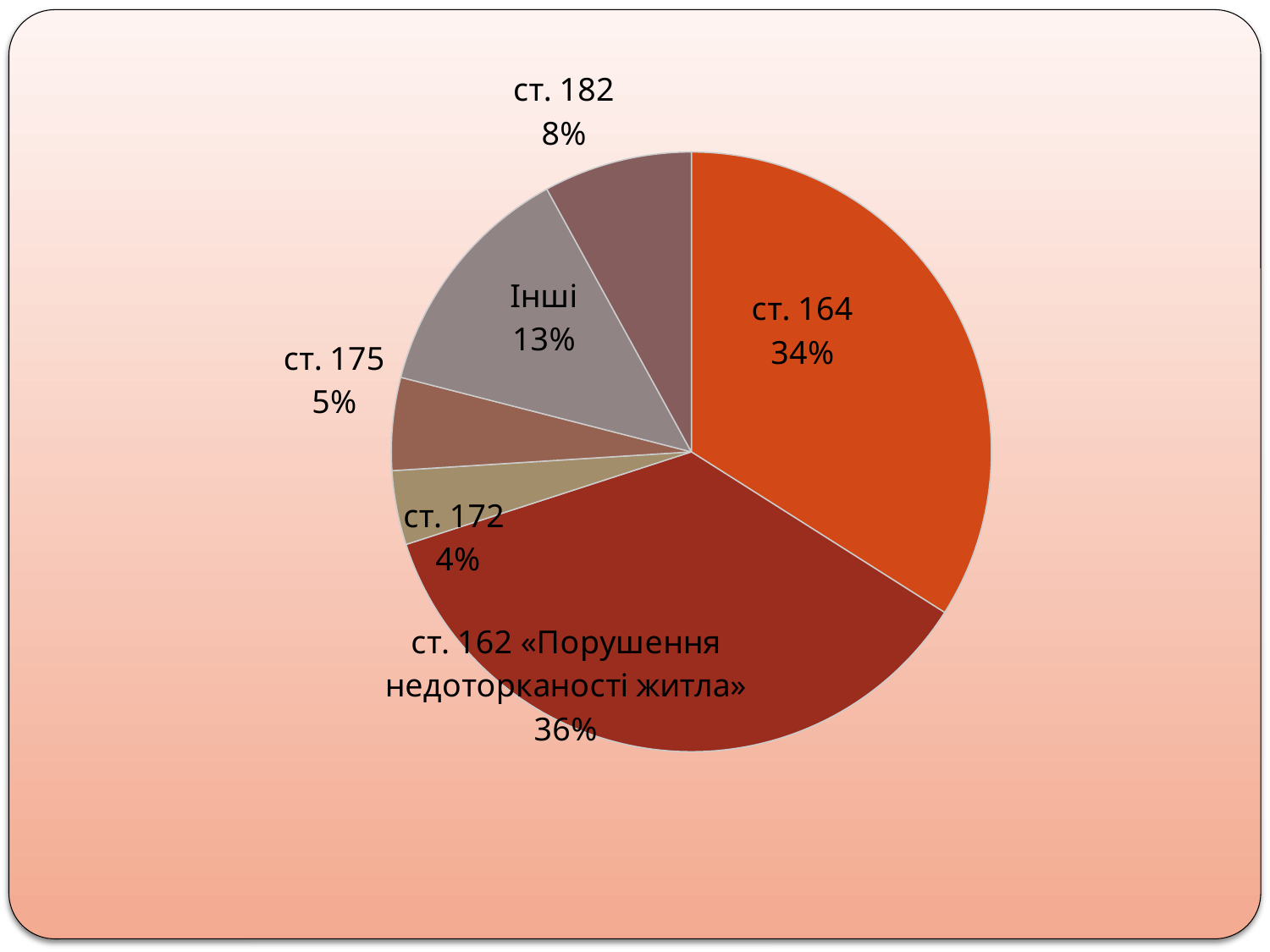
What share of the pie does ст. 172 have? 4% What share of the pie does ст. 175 have? 5% What share of the pie does Інші have? 13% What kind of chart is shown on the slide? pie chart Which slice has the smallest share of the pie? ст. 172 Which slice has the largest share of the pie? ст. 162 «Порушення недоторканості житла» What is the difference in percentage points between the shares of Інші and ст. 182? 5 How many slices does the pie chart have? 6 Which has a larger share, ст. 175 or ст. 182? ст. 182